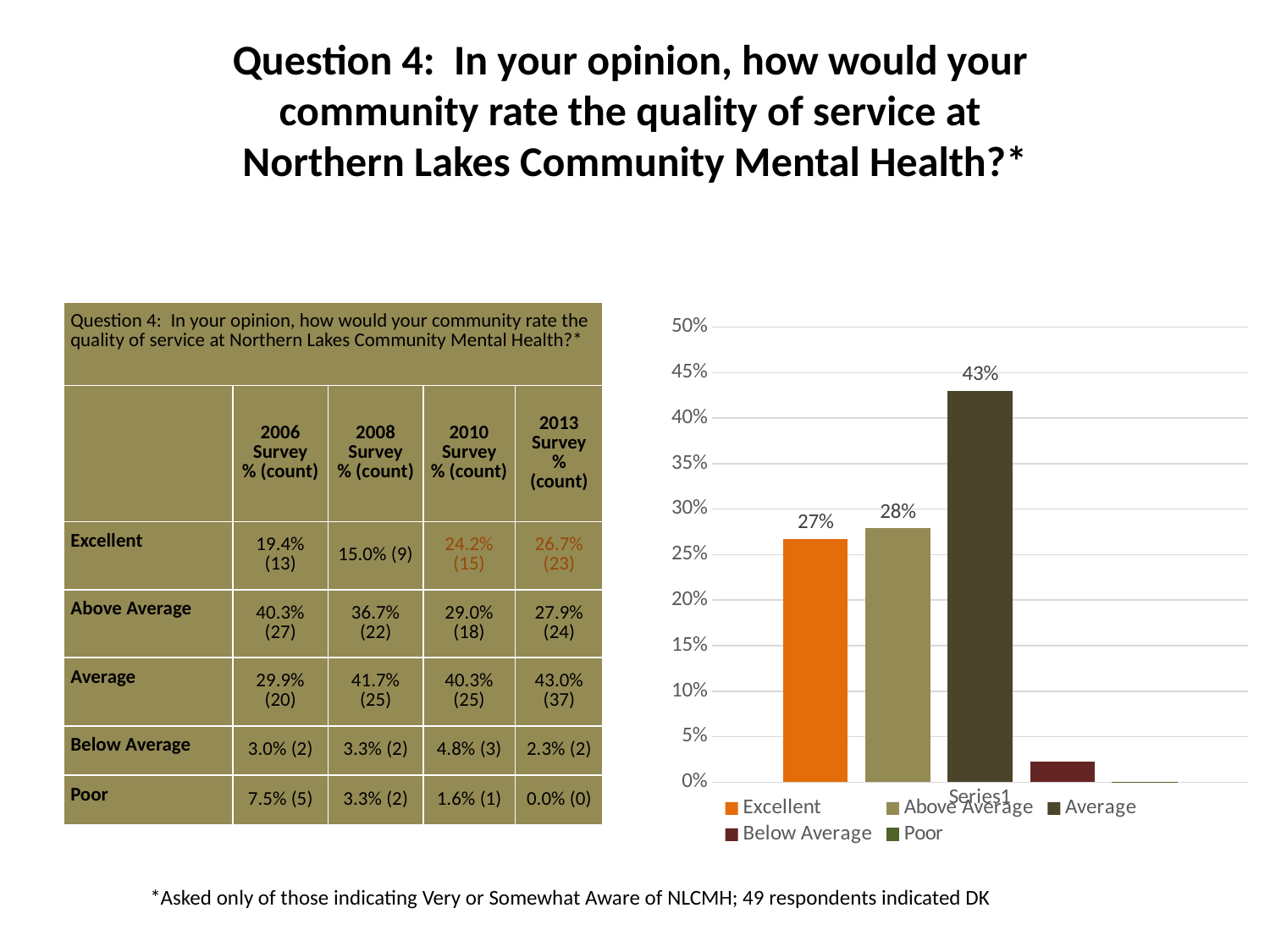
How many series does the chart legend list? 5 What is the highest value shown on the chart's vertical axis? 50% What is the value shown for Average in the chart? 43% Which series has the highest bar in the chart? Average What is the value shown for Excellent in the chart? 27% What is the difference between the Average and Excellent values in the chart? 16% Which series has the lowest bar in the chart? Poor Which is larger in the chart, the value for Average or the value for Excellent? Average What is the value shown for Above Average in the chart? 28% Is the value for Below Average in the chart greater or less than 5%? less What is the difference between the Average and Above Average values in the chart? 15% What kind of chart is shown on the slide? bar chart